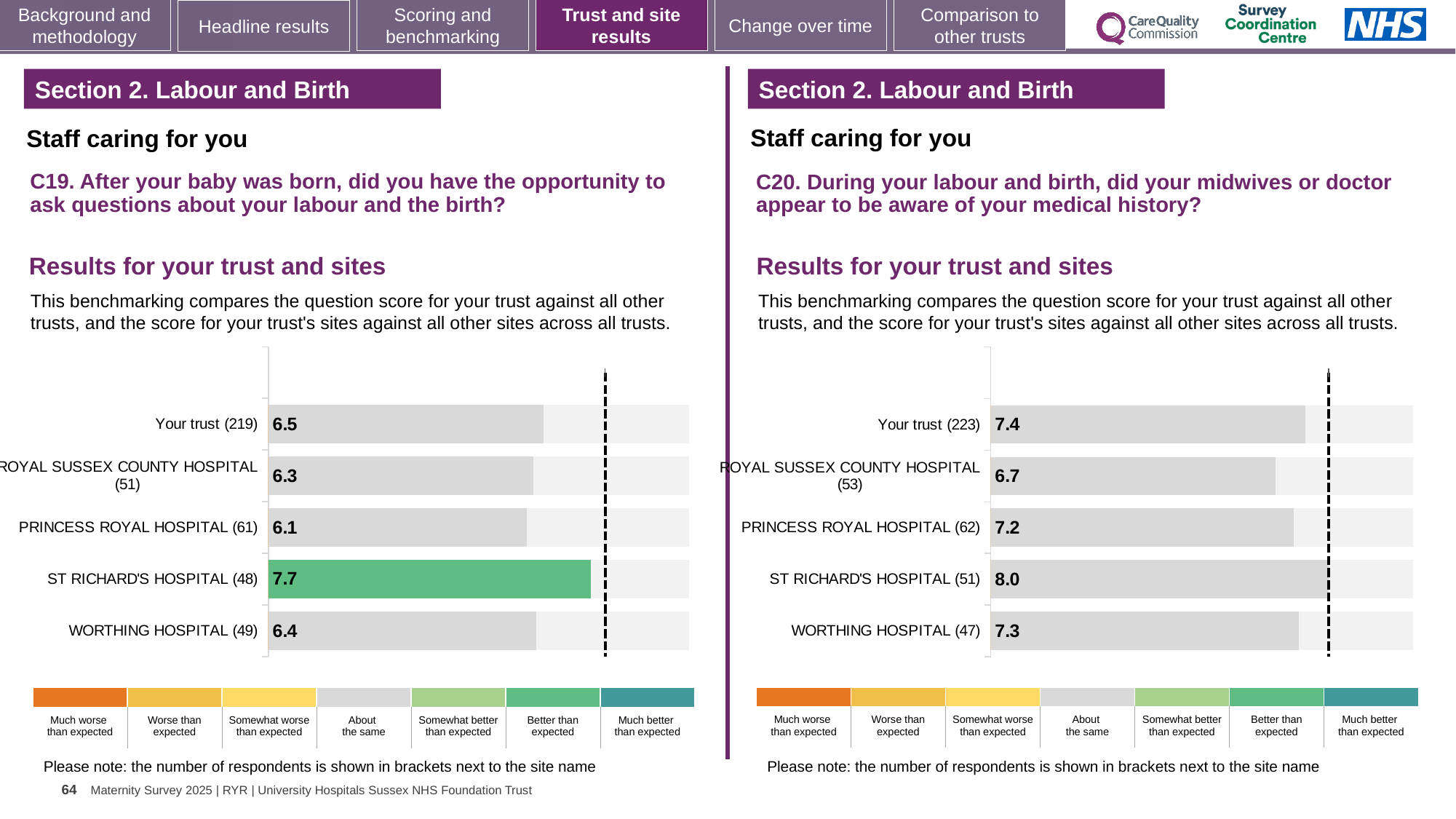
In the C20 chart on the right, which site has the highest score? St Richard's Hospital In the C20 chart on the right, what is the difference between the scores for St Richard's Hospital and Royal Sussex County Hospital? 1.3 In the C19 chart on the left, which site has the lowest score? Princess Royal Hospital In the C20 chart on the right, which has the larger score, Your trust or Princess Royal Hospital? Your trust In the C20 chart on the right, what is the score for Worthing Hospital? 7.3 What kind of chart is used in the C20 chart on the right? Bar chart In the C19 chart on the left, how many bars are plotted? 5 In the C19 chart on the left, what is the difference between the scores for St Richard's Hospital and Princess Royal Hospital? 1.6 In the C19 chart on the left, what is the score for St Richard's Hospital? 7.7 In the C19 chart on the left, what is the score for Your trust? 6.5 In the C20 chart on the right, what is the score for Royal Sussex County Hospital? 6.7 In the C19 chart on the left, which bar is coloured green rather than grey? St Richard's Hospital